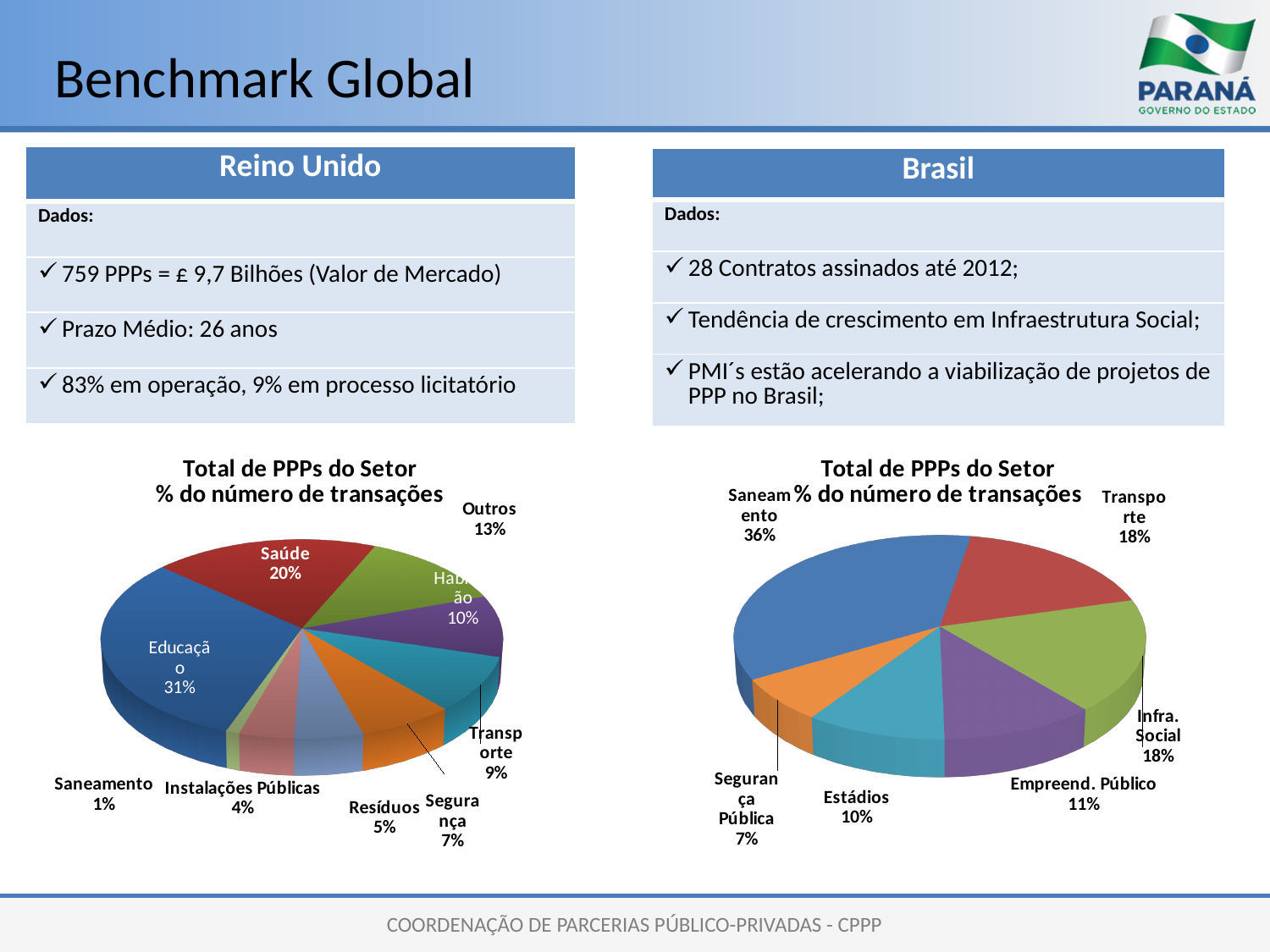
In the Reino Unido pie chart, what is the difference between the shares of Saúde and Transporte? 11% In the Reino Unido pie chart, what share of transactions is Saúde? 20% In the Reino Unido pie chart, which sector has the largest share? Educação In the Reino Unido pie chart, how many sectors are shown? 9 In the Brasil pie chart, what share of transactions is Estádios? 10% In the Reino Unido pie chart, what share of transactions is Educação? 31% In the Brasil pie chart, which is larger: Empreend. Público or Transporte? Transporte In the Reino Unido pie chart, which sector has the smallest share? Saneamento What type of chart is used under the Brasil section? Pie chart In the Brasil pie chart, what share of transactions is Saneamento? 36% In the Brasil pie chart, which sector has the smallest share? Segurança Pública In the Brasil pie chart, how many sectors are shown? 6